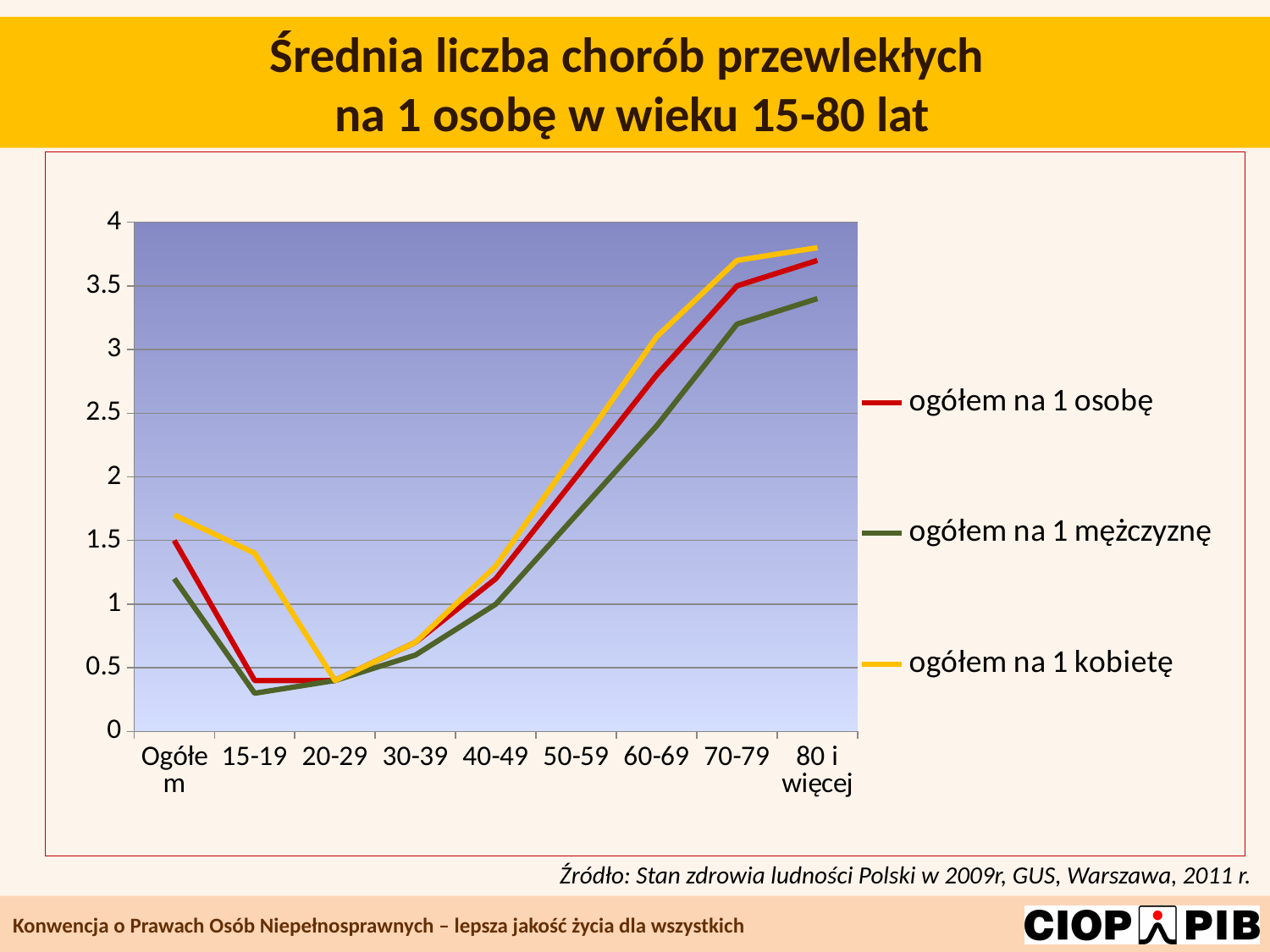
In the 15-19 category, which series has the larger value: 'ogółem na 1 kobietę' or 'ogółem na 1 mężczyznę'? ogółem na 1 kobietę Is the value for 'ogółem na 1 mężczyznę' in the 40-49 category greater or less than 1.5? less What colour is the line for 'ogółem na 1 kobietę'? yellow Is the value for 'ogółem na 1 osobę' in the 60-69 category greater or less than 2.5? greater Do the values of 'ogółem na 1 osobę' rise or fall from the 20-29 category to the 80 i więcej category? rise How many series does the legend list? 3 For which category is the value of 'ogółem na 1 kobietę' highest? 80 i więcej What kind of chart is shown on the slide? line chart Is the value for 'ogółem na 1 kobietę' in the 15-19 category greater or less than 1? greater In the 70-79 category, which series has the larger value: 'ogółem na 1 osobę' or 'ogółem na 1 mężczyznę'? ogółem na 1 osobę How many age categories are shown on the x axis? 9 For which category is the value of 'ogółem na 1 mężczyznę' lowest? 15-19